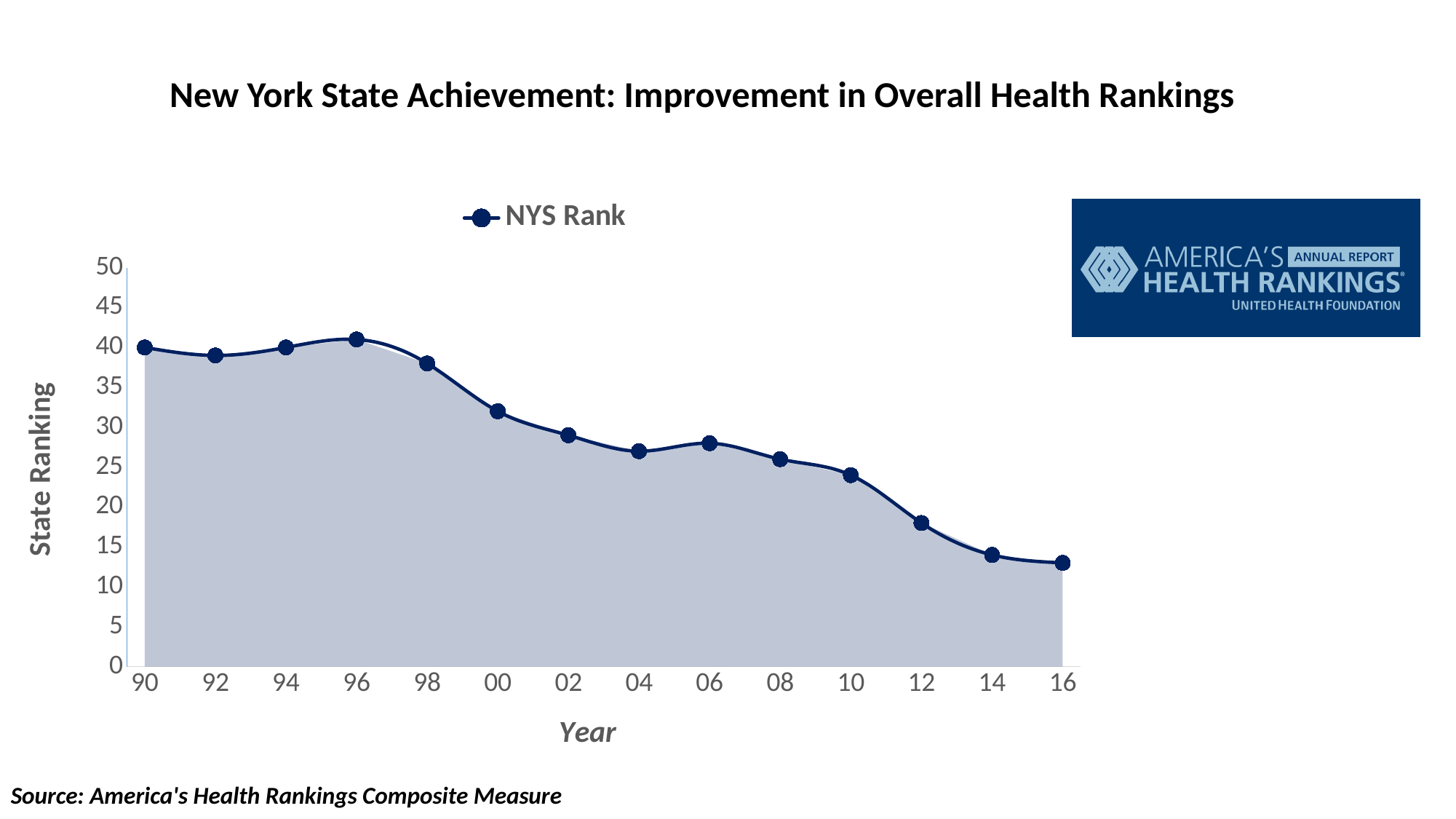
In which year is the NYS Rank highest? 96 How many data points are plotted on the line? 14 What kind of chart is shown on the slide? Area and line chart (a line with markers over a shaded area) Is the NYS Rank value for 00 greater or less than 35? less Do the NYS Rank values generally rise or fall from 90 to 16? Fall Is the NYS Rank value for 12 greater or less than 20? less What is the title of the vertical axis? State Ranking Is the NYS Rank value for 06 greater or less than 25? greater What is the name of the series shown in the legend? NYS Rank Which year has the larger NYS Rank value, 98 or 00? 98 How many series does the legend list? 1